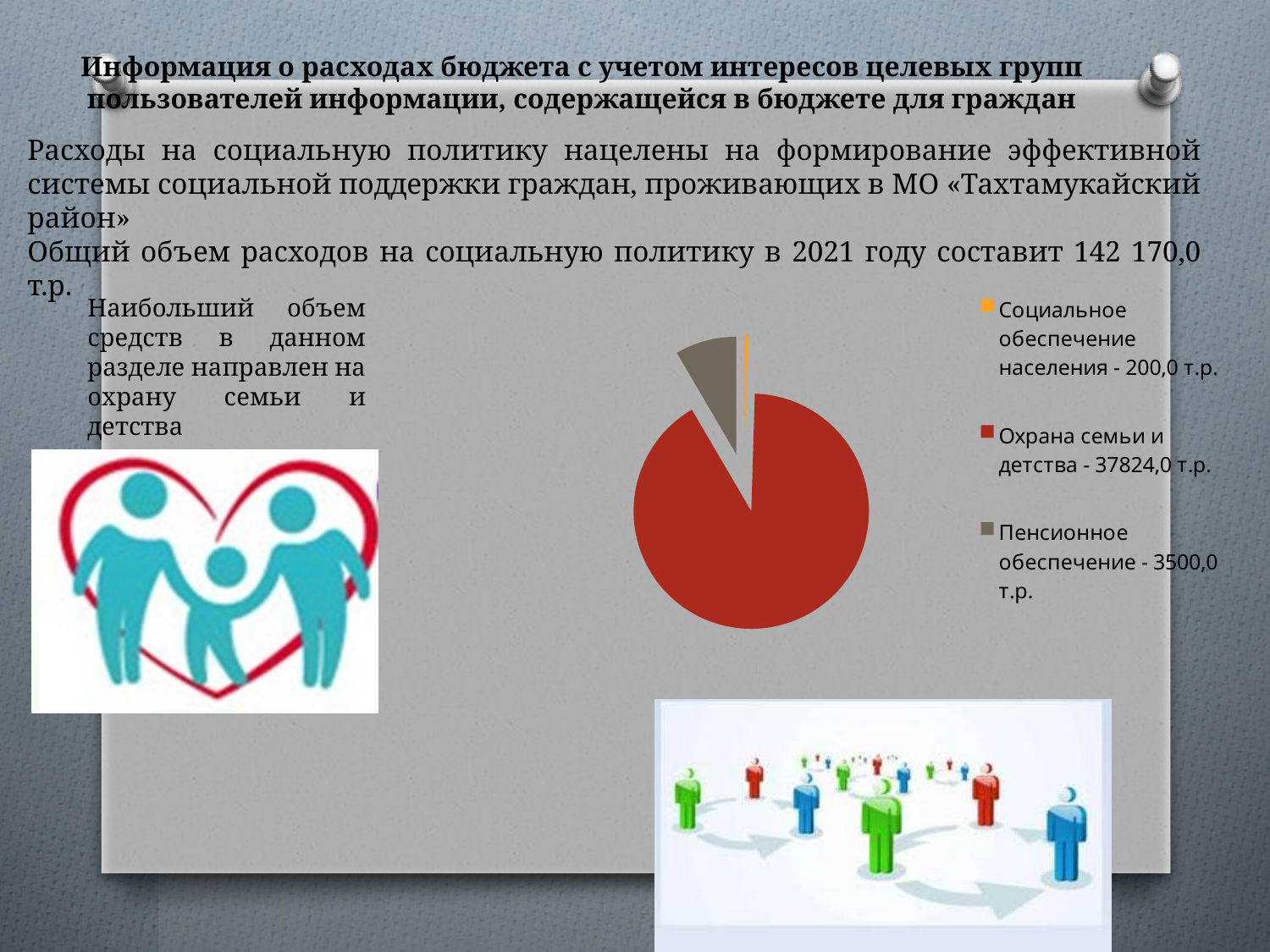
What colour is the slice for Охрана семьи и детства in the pie chart? Red What kind of chart is shown on the slide? Pie chart How many entries does the legend of the pie chart list? 3 Which category has the largest slice in the pie chart? Охрана семьи и детства What is the difference between the values for Пенсионное обеспечение and Социальное обеспечение населения? 3300,0 т.р. Which is larger: Пенсионное обеспечение or Социальное обеспечение населения? Пенсионное обеспечение What is the value for Охрана семьи и детства in the pie chart? 37824,0 т.р. What is the value for Пенсионное обеспечение in the pie chart? 3500,0 т.р. What is the value for Социальное обеспечение населения in the pie chart? 200,0 т.р. Which category has the smallest slice in the pie chart? Социальное обеспечение населения What is the difference between the values for Охрана семьи и детства and Пенсионное обеспечение? 34324,0 т.р. How many slices does the pie chart have? 3